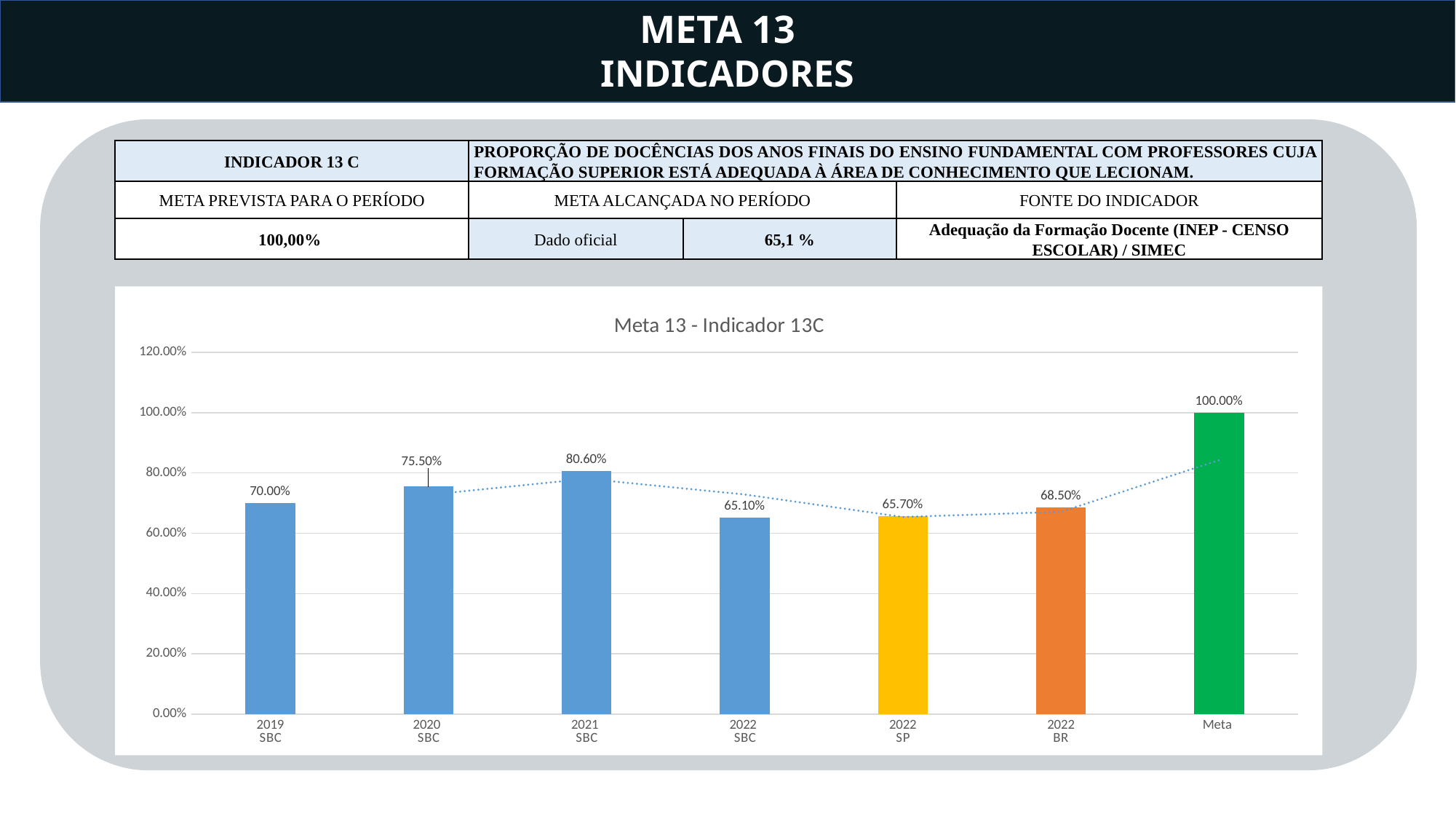
What kind of chart is shown on the slide? Bar chart How many bars are plotted in the chart? 7 What is the value for 2022 BR in the chart? 68.50% What is the title of the chart? Meta 13 - Indicador 13C Which is larger, the value for 2020 SBC or the value for 2022 BR? 2020 SBC What is the difference between the Meta value and the 2022 BR value? 31.50% What is the value for 2021 SBC in the Meta 13 - Indicador 13C chart? 80.60% What is the value of the Meta bar in the chart? 100.00% Which category has the highest value in the chart? Meta What is the difference between the 2021 SBC value and the 2022 SBC value? 15.50% Which category has the lowest value in the chart? 2022 SBC What is the value for 2022 SP in the chart? 65.70%